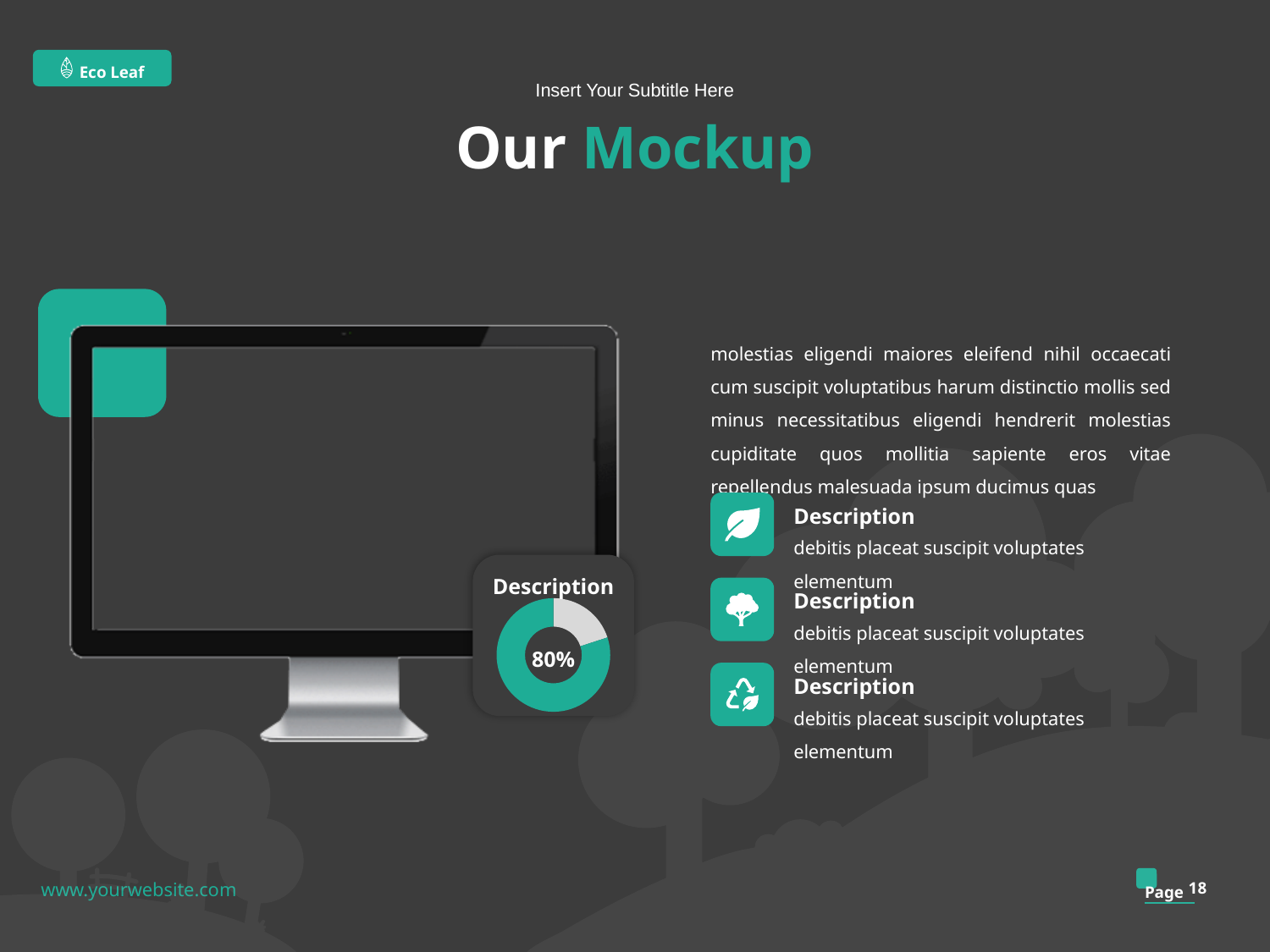
What percentage is printed in the centre of the doughnut chart? 80% What colour is the largest segment of the doughnut chart? Teal What is the title shown above the doughnut chart? Description Which segment of the doughnut chart is larger, the teal one or the grey one? The teal one What kind of chart is shown next to the monitor on the slide? Doughnut chart How many segments does the doughnut chart have? 2 Is the value shown by the teal segment of the doughnut chart greater or less than 50%? greater